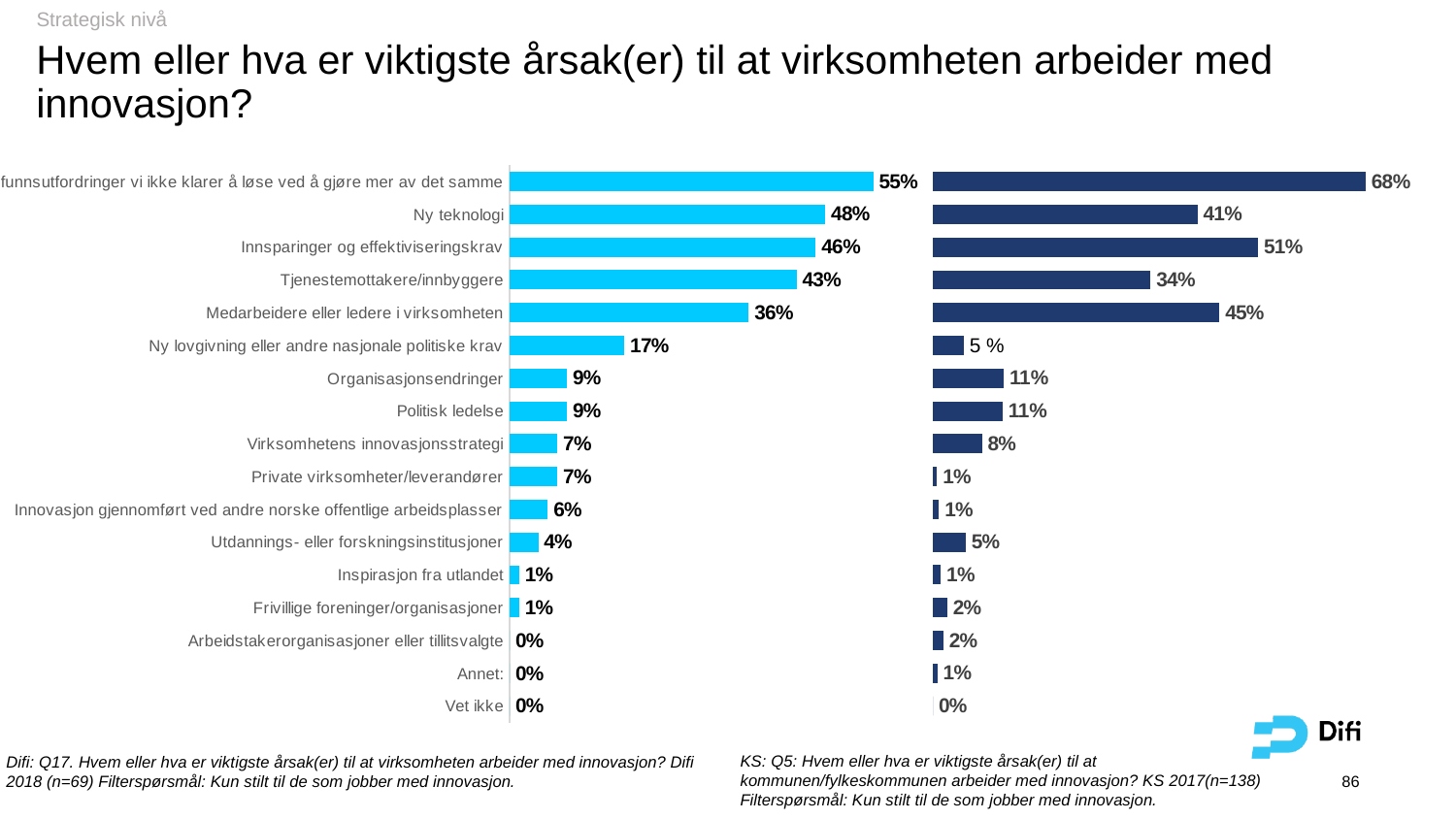
In the right (dark blue) chart, what is the value for Medarbeidere eller ledere i virksomheten? 45% How many categories are listed in the charts? 17 In the left (light blue) chart, what is the value for Ny lovgivning eller andre nasjonale politiske krav? 17% In the right (dark blue) chart, what is the highest value shown? 68% In the right (dark blue) chart, what is the value for Tjenestemottakere/innbyggere? 34% Which is larger for Medarbeidere eller ledere i virksomheten: the left (light blue) chart or the right (dark blue) chart? The right (dark blue) chart, 45% In the left (light blue) chart, what is the difference between Ny teknologi and Innsparinger og effektiviseringskrav? 2 percentage points In the left (light blue) chart, which category has the highest value? The top category (…funnsutfordringer vi ikke klarer å løse ved å gjøre mer av det samme), 55% In the left (light blue) chart, what is the value for Ny teknologi? 48% In the right (dark blue) chart, what is the value for Innsparinger og effektiviseringskrav? 51% What type of chart is used on this slide? Bar chart In the right (dark blue) chart, what is the difference between Innsparinger og effektiviseringskrav and Ny teknologi? 10 percentage points